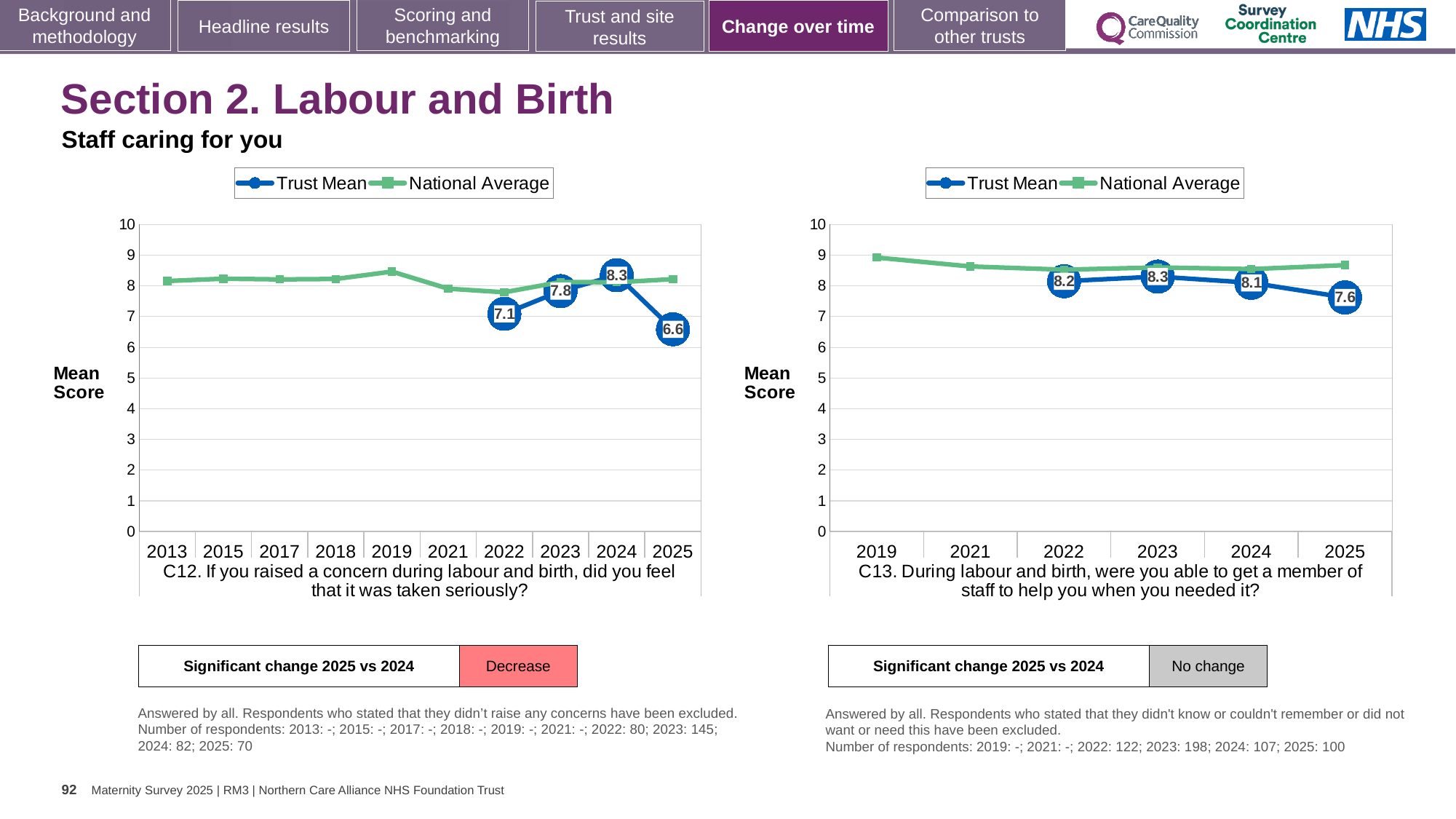
In the C12 chart, what is the Trust Mean for 2025? 6.6 In the C13 chart, what is the Trust Mean for 2025? 7.6 How many series does the legend of the C13 chart list? 2 In the C12 chart, which year has the highest labelled Trust Mean? 2024 In the C12 chart, what is the Trust Mean for 2022? 7.1 What kind of chart is the C12 chart? line chart In the C13 chart, which year has the lowest labelled Trust Mean? 2025 In the C12 chart, is the National Average for 2013 greater or less than 7? greater In the C12 chart, how many years are shown on the x axis? 10 In the C13 chart, does the Trust Mean rise or fall from 2023 to 2025? fall In the C12 chart, what is the difference between the Trust Mean in 2024 and in 2025? 1.7 In the C13 chart, is the Trust Mean higher in 2023 or in 2025? 2023